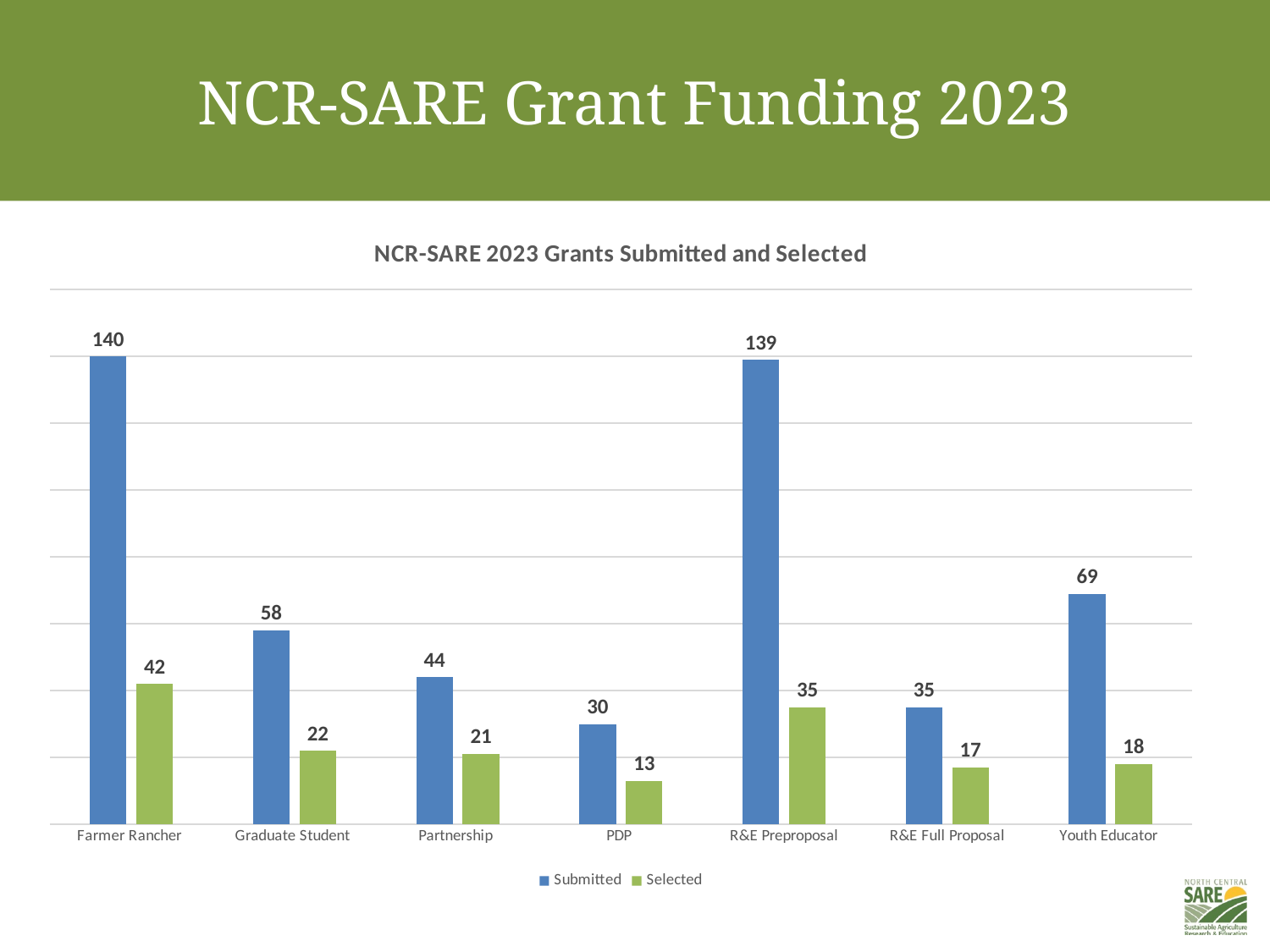
What kind of chart is shown on the slide? Bar chart Which category has the highest Selected value? Farmer Rancher What is the Submitted value for Youth Educator? 69 How many categories are shown on the x axis? 7 What is the Selected value for R&E Preproposal? 35 What is the Selected value for PDP? 13 What is the Submitted value for Farmer Rancher? 140 What is the difference between the Submitted and Selected values for Graduate Student? 36 Which is larger, the Selected value for Partnership or the Selected value for Graduate Student? Graduate Student What is the difference between the Submitted values for Youth Educator and R&E Full Proposal? 34 Which category has the lowest Submitted value? PDP How many series does the legend list? 2